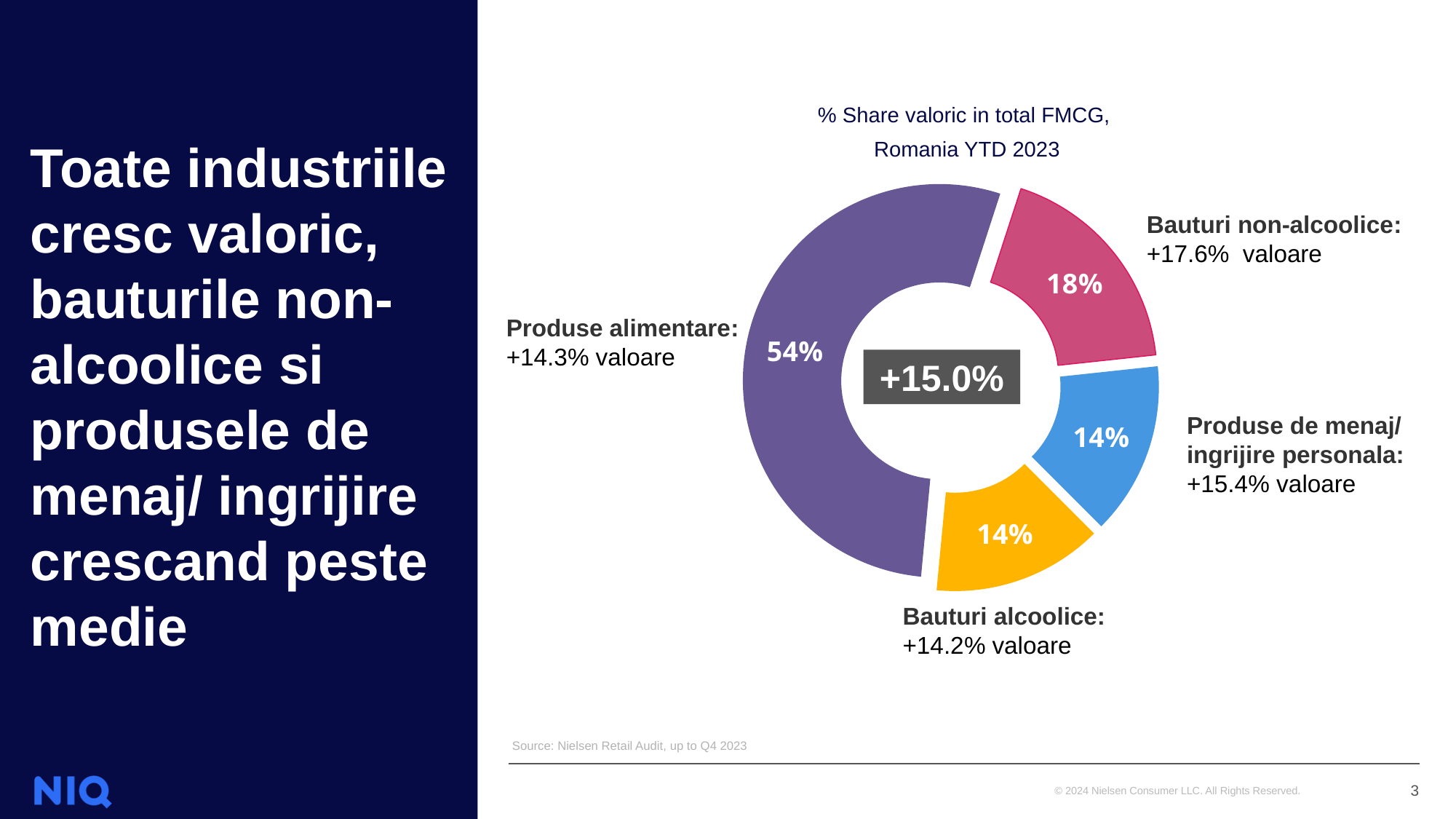
What is the difference in share between Produse alimentare and Bauturi non-alcoolice? 36 percentage points What value growth is shown for Bauturi non-alcoolice? +17.6% What share of total FMCG value does Produse alimentare hold? 54% What share of total FMCG value does Bauturi alcoolice hold? 14% What is the title of the chart? % Share valoric in total FMCG, Romania YTD 2023 What share of total FMCG value does Bauturi non-alcoolice hold? 18% What value is shown in the centre of the donut chart? +15.0% How many categories are shown in the chart? 4 Which category has the largest share of total FMCG value? Produse alimentare What value growth is shown for Produse de menaj/ ingrijire personala? +15.4% Which has a larger share, Bauturi non-alcoolice or Produse de menaj/ ingrijire personala? Bauturi non-alcoolice What type of chart is shown on the slide? Pie chart (donut)